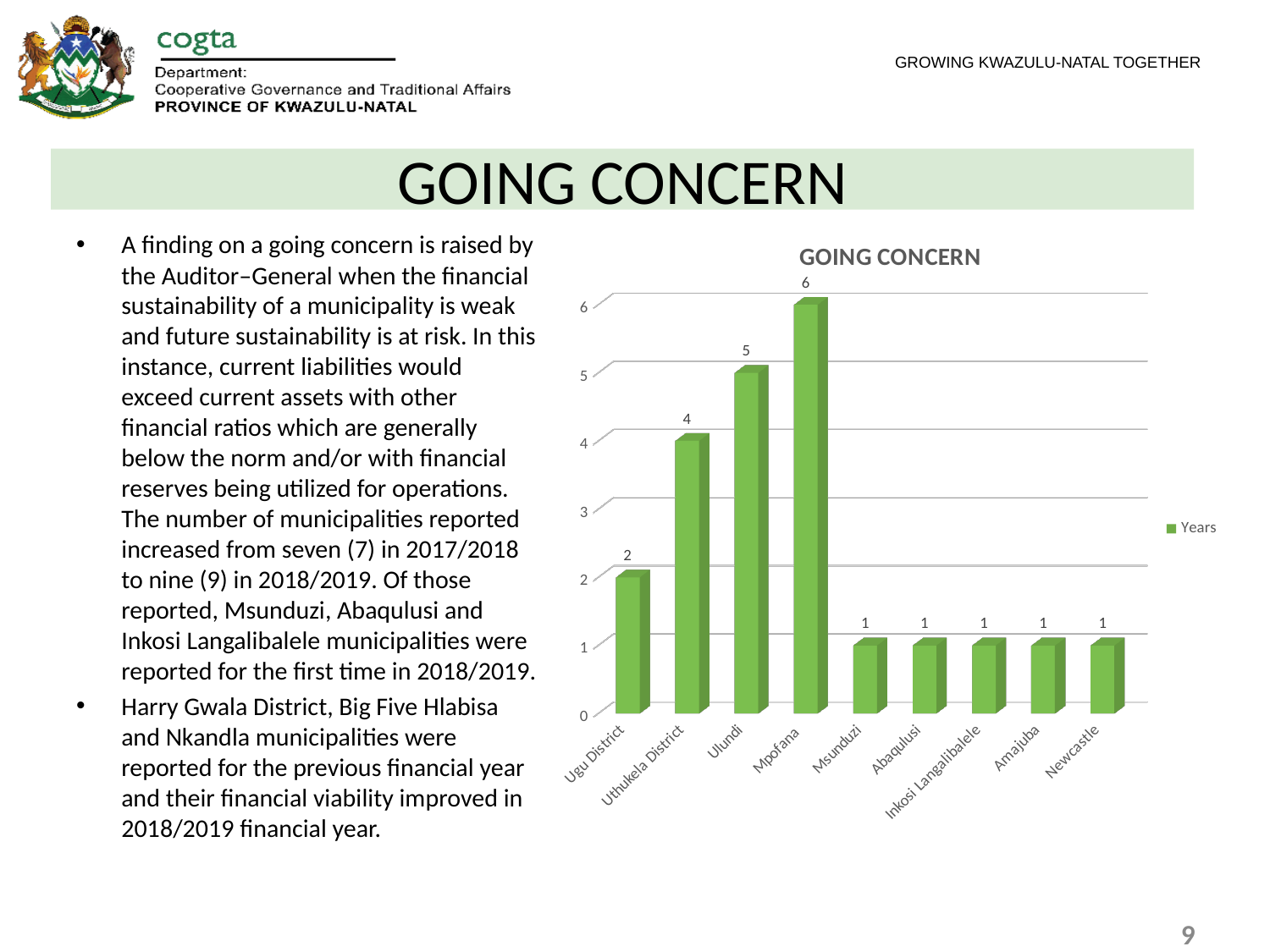
What is the value for Ugu District in the GOING CONCERN chart? 2 How many series does the legend of the GOING CONCERN chart list? 1 Which is larger, the value for Ulundi or the value for Ugu District? Ulundi What is the difference between the values for Mpofana and Uthukela District? 2 Is the value for Uthukela District greater or less than 3? greater What is the value for Newcastle in the GOING CONCERN chart? 1 What is the value for Mpofana in the GOING CONCERN chart? 6 What is the name of the series listed in the chart legend? Years What is the value for Ulundi in the GOING CONCERN chart? 5 What kind of chart is shown on the slide? bar chart How many categories are shown on the x axis of the GOING CONCERN chart? 9 Which category has the highest value in the GOING CONCERN chart? Mpofana